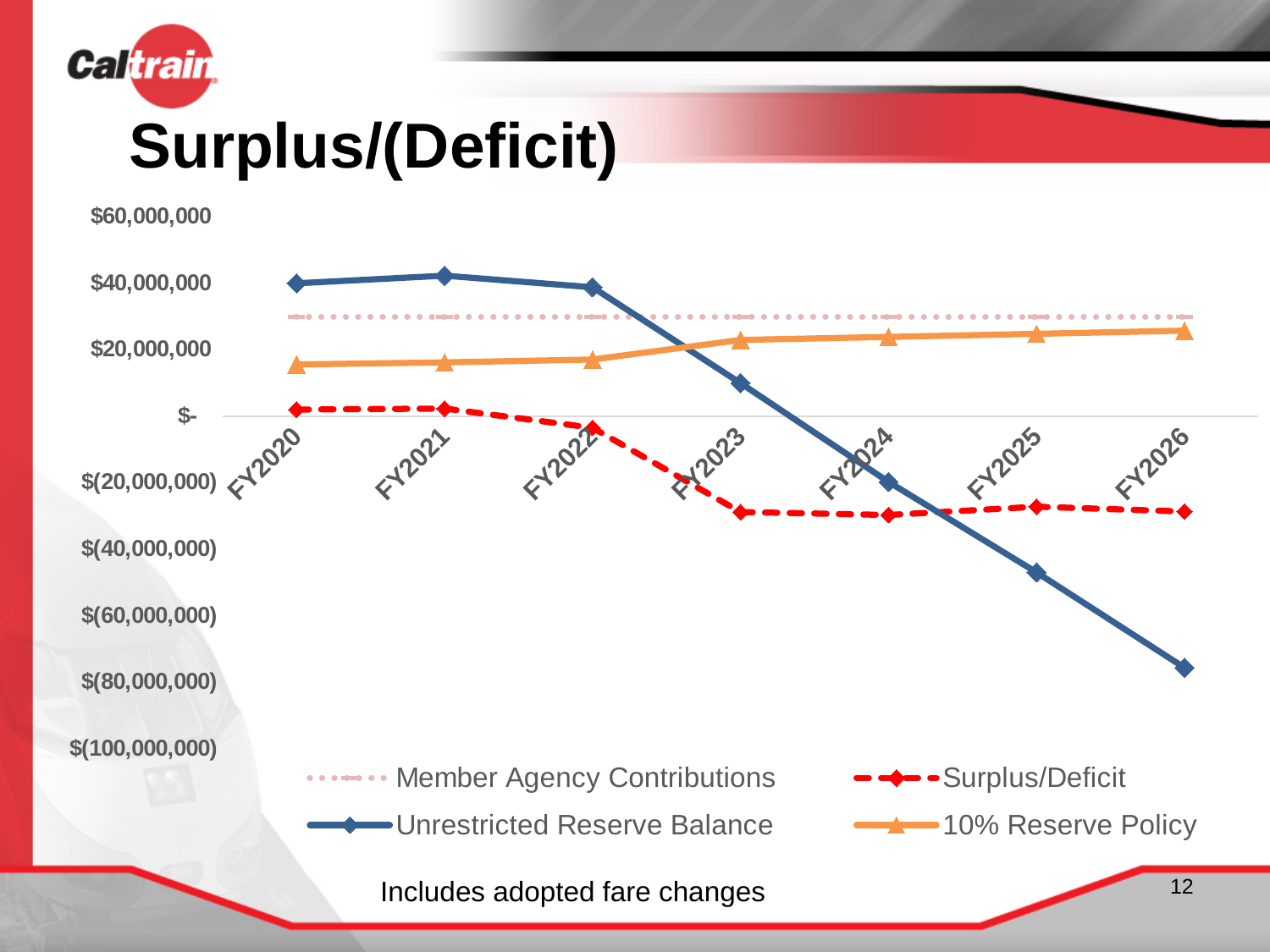
Is the Unrestricted Reserve Balance for FY2020 greater or less than $20,000,000? greater In which fiscal year is the Unrestricted Reserve Balance highest? FY2021 Is the 10% Reserve Policy value for FY2020 greater or less than $20,000,000? less In which fiscal year is the Unrestricted Reserve Balance lowest? FY2026 Is the Unrestricted Reserve Balance for FY2026 greater or less than $(60,000,000)? less What is the title of the chart? Surplus/(Deficit) How many fiscal years are plotted along the x axis? 7 Does the Unrestricted Reserve Balance rise or fall from FY2021 to FY2026? Fall How many series does the legend list? 4 What kind of chart is shown on the slide? Line chart Does the 10% Reserve Policy line rise or fall from FY2020 to FY2026? Rise In FY2024, which is larger: the Unrestricted Reserve Balance or the 10% Reserve Policy? 10% Reserve Policy